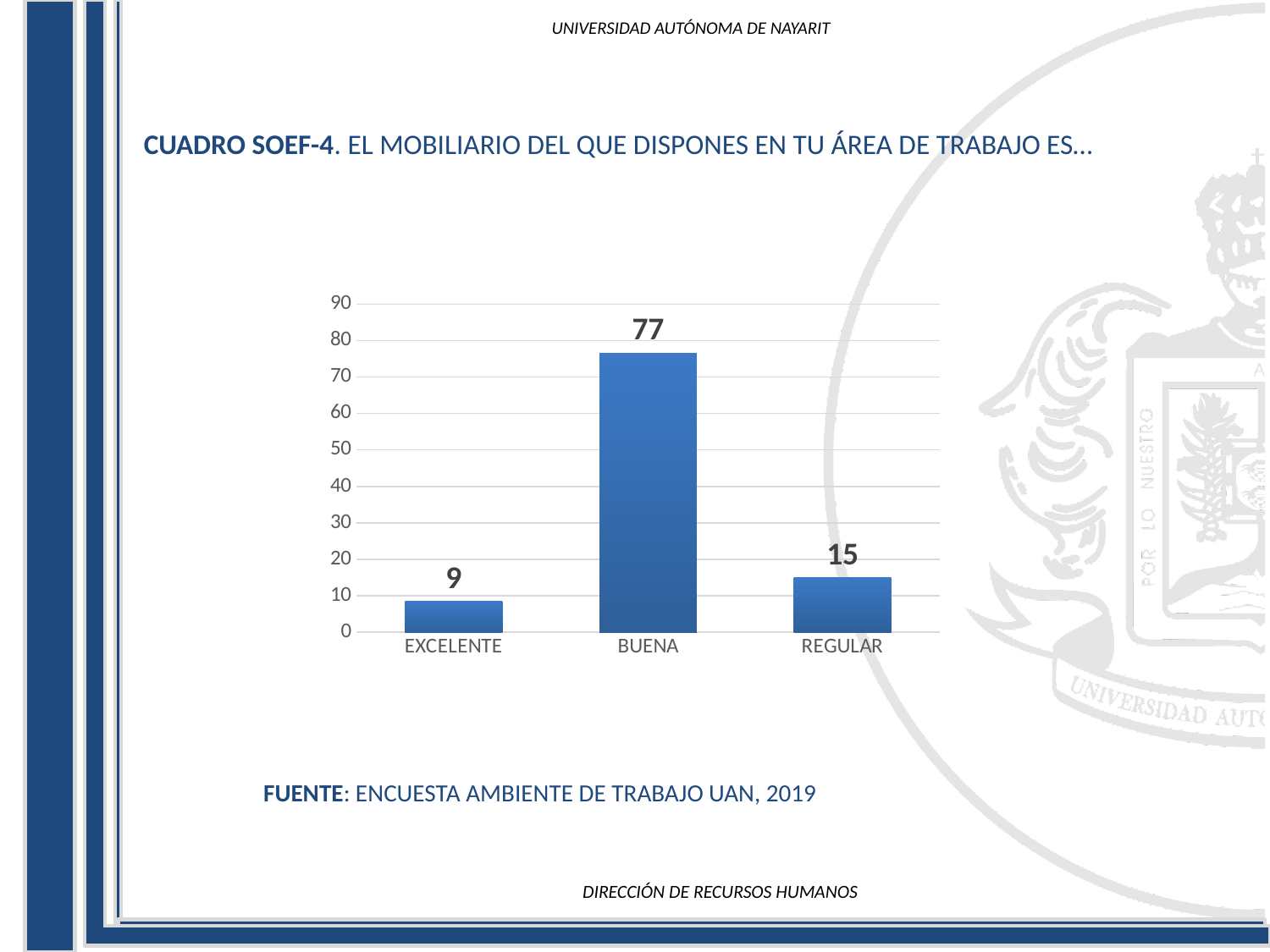
Is the value for BUENA greater or less than 70? greater What kind of chart is shown on the slide? bar chart What is the difference between the values for BUENA and REGULAR? 62 How many categories are shown on the x axis? 3 Which category has the lowest value? EXCELENTE What is the value for EXCELENTE? 9 What is the source cited below the chart? ENCUESTA AMBIENTE DE TRABAJO UAN, 2019 Which is larger, the value for REGULAR or the value for EXCELENTE? REGULAR Which category has the highest value? BUENA What is the value for BUENA? 77 What is the difference between the values for REGULAR and EXCELENTE? 6 What is the value for REGULAR? 15